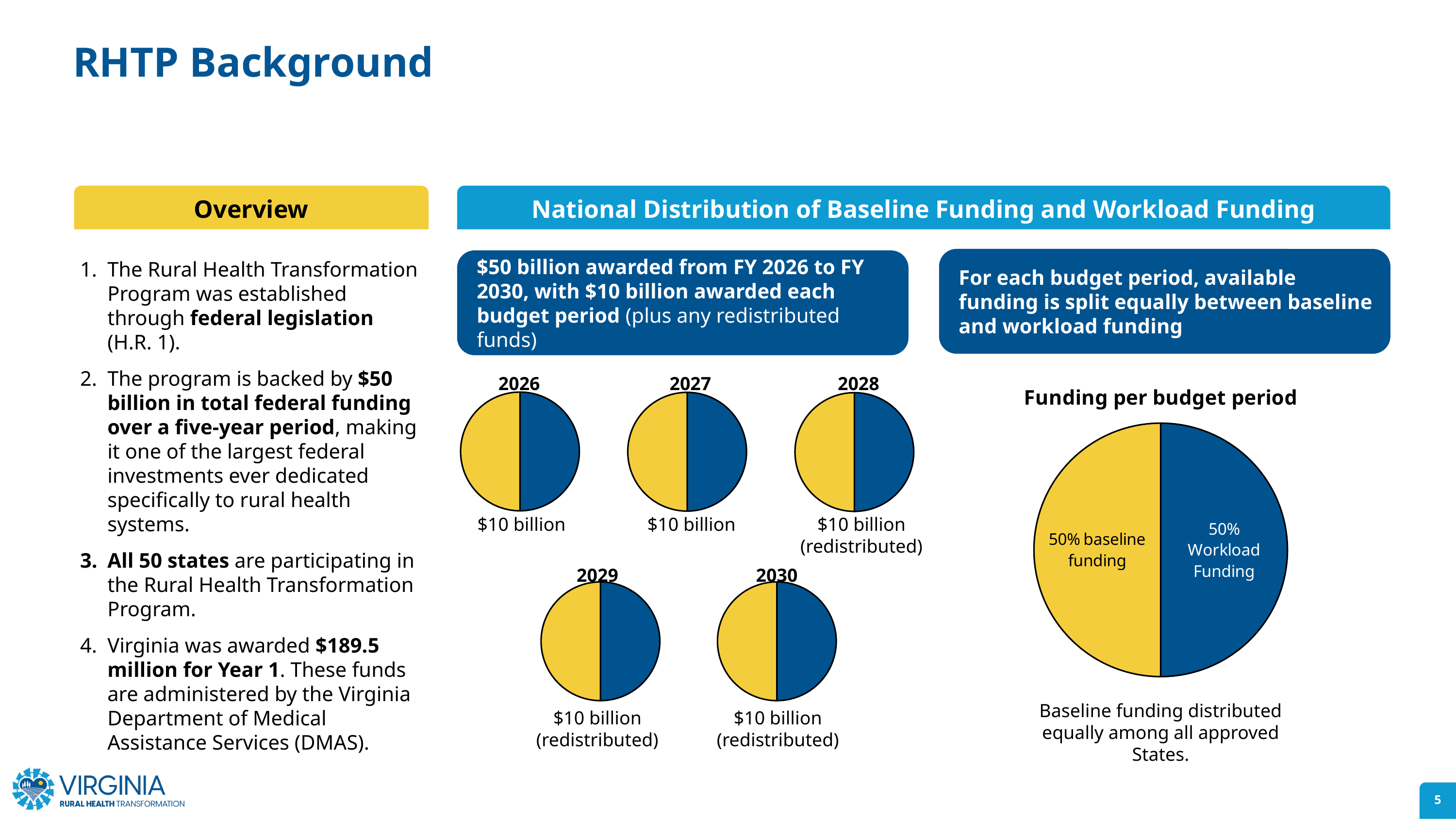
How many slices does the "Funding per budget period" pie chart have? 2 What amount is labelled under the 2029 pie chart? $10 billion (redistributed) What kind of chart is the "Funding per budget period" chart? pie chart In the "Funding per budget period" pie chart, what share is Workload Funding? 50% In the "Funding per budget period" pie chart, what share is baseline funding? 50% What is the total funding across the five budget-period pie charts (2026 to 2030)? $50 billion How many small pie charts are shown for the budget periods 2026 through 2030? 5 In the "Funding per budget period" pie chart, what colour is the Workload Funding slice? blue What is the title of the large pie chart on the right of the slide? Funding per budget period Which budget-period pie charts are labelled as redistributed funds? 2028, 2029 and 2030 What amount is labelled under the 2026 pie chart? $10 billion In the "Funding per budget period" pie chart, what colour is the baseline funding slice? yellow